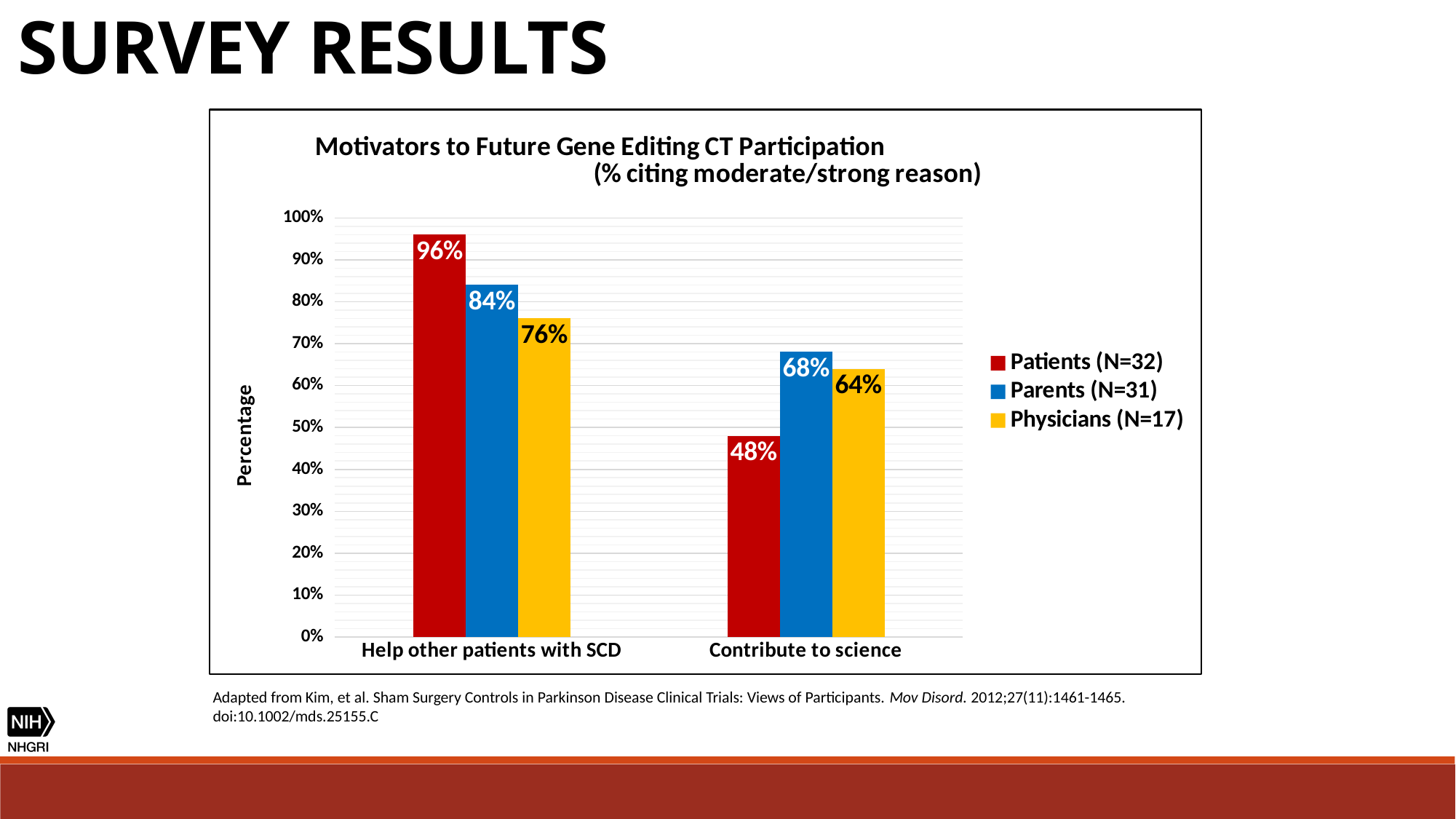
How many series does the legend list? 3 What is the value for Physicians (N=17) in the 'Contribute to science' category? 64% What is the value for Parents (N=31) in the 'Help other patients with SCD' category? 84% What is the difference between Parents (N=31) and Physicians (N=17) in the 'Contribute to science' category? 4% Which group has the lowest value for 'Contribute to science'? Patients (N=32) Which is larger: the Parents (N=31) value for 'Contribute to science' or the Physicians (N=17) value for 'Help other patients with SCD'? Physicians (N=17) value for 'Help other patients with SCD' Which group has the highest value for 'Help other patients with SCD'? Patients (N=32) What is the difference between the Patients (N=32) values for 'Help other patients with SCD' and 'Contribute to science'? 48% What kind of chart is shown on the slide? Bar chart How many categories are shown on the x axis? 2 What percentage of Patients (N=32) cited 'Help other patients with SCD' as a moderate/strong reason? 96% What is the label of the y axis? Percentage